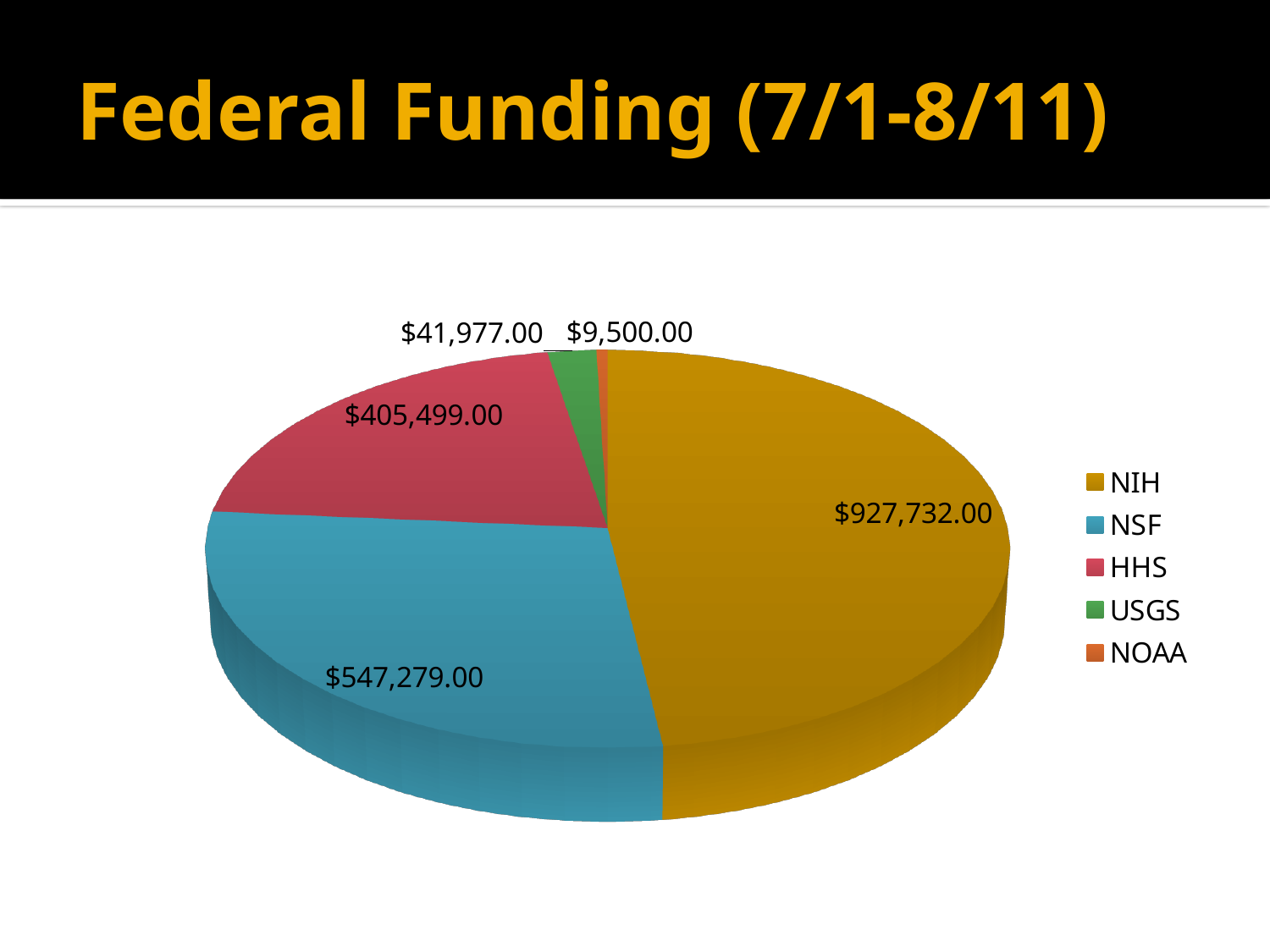
What is the funding value for HHS? $405,499.00 What is the difference between the NIH and NSF funding values? $380,453.00 Which agency has the smallest share of federal funding? NOAA What is the funding value for NSF? $547,279.00 What type of chart is shown on the slide? pie chart Which agency has the largest share of federal funding? NIH What is the funding value for NOAA? $9,500.00 What is the difference between the USGS and NOAA funding values? $32,477.00 What is the title of the chart? Federal Funding (7/1-8/11) Which is larger, the funding for NSF or for HHS? NSF What is the funding value for NIH? $927,732.00 How many agencies are listed in the legend? 5